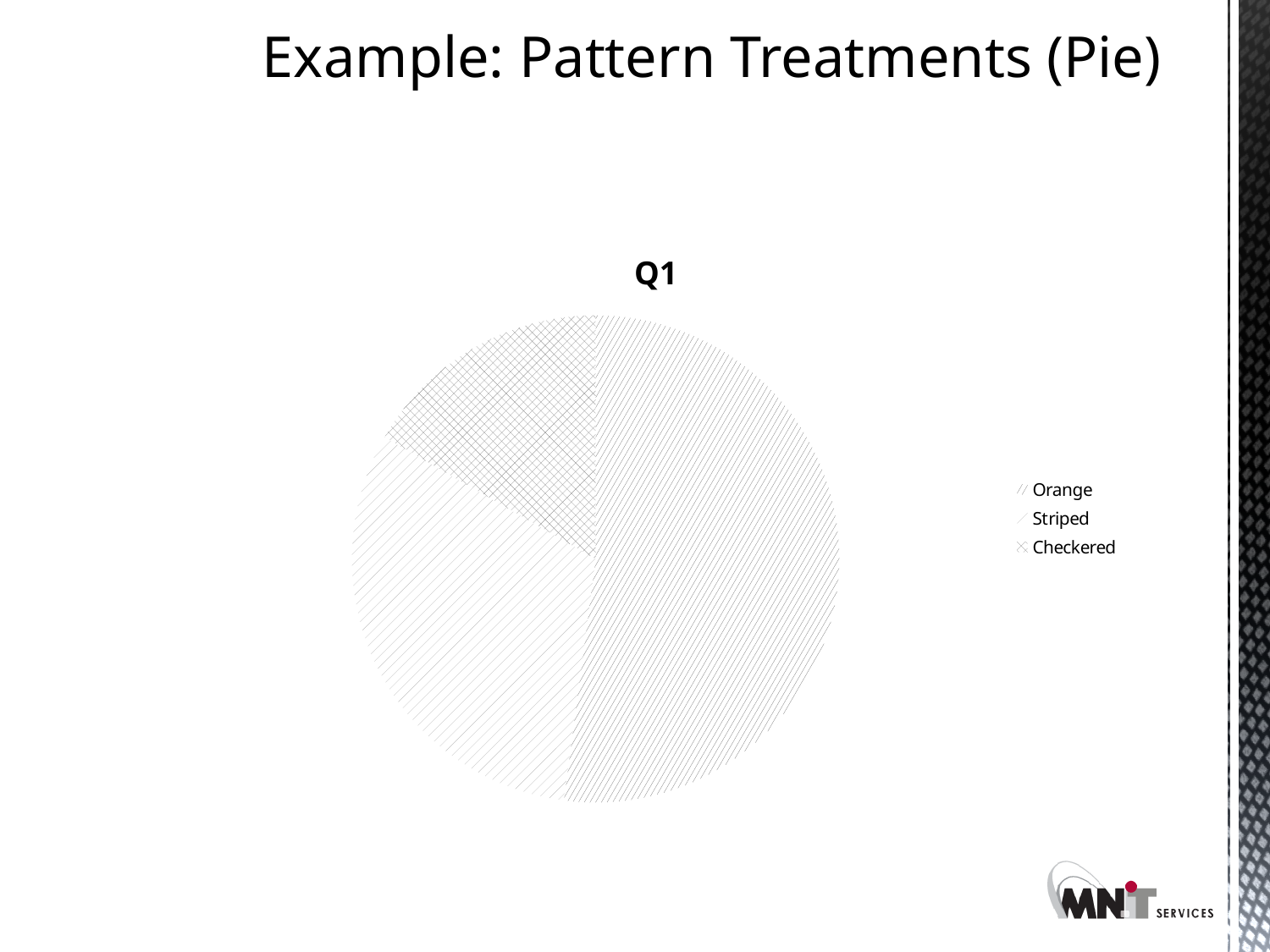
Which category has the largest slice of the pie? Orange Which legend entry is shown with a cross-hatch (checkered) pattern? Checkered How many slices does the pie chart have? 3 How many entries does the legend list? 3 Which slice is larger, Striped or Checkered? Striped What kind of chart is shown on the slide? pie chart Which slice is larger, Orange or Striped? Orange What is the title of the pie chart? Q1 Which category has the smallest slice of the pie? Checkered